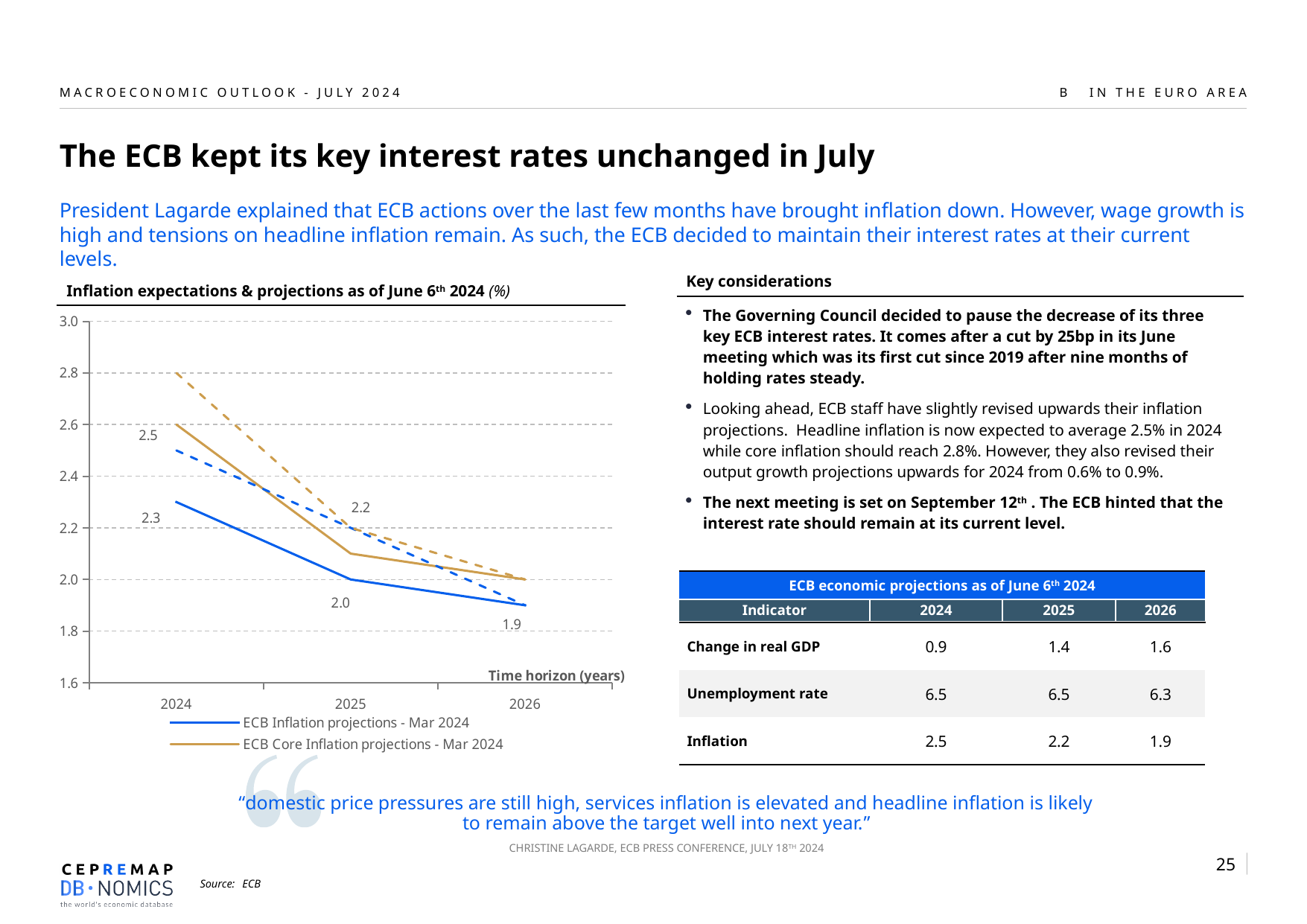
Is the value of ECB Core Inflation projections - Mar 2024 for 2025 greater or less than 2.0? greater What kind of chart is shown on the slide? line chart Do the values of ECB Inflation projections - Mar 2024 rise or fall from 2024 to 2026? fall What is the value of ECB Inflation projections - Mar 2024 for 2026? 1.9 For 2024, which is larger: ECB Core Inflation projections - Mar 2024 or ECB Inflation projections - Mar 2024? ECB Core Inflation projections - Mar 2024 In which year is ECB Inflation projections - Mar 2024 highest? 2024 What is the title of the x axis of the chart? Time horizon (years) Is the value of ECB Core Inflation projections - Mar 2024 for 2024 greater or less than 2.4? greater What is the value of ECB Inflation projections - Mar 2024 for 2025? 2.0 How many years are shown on the x axis of the chart? 3 How many series does the chart legend list? 2 What is the value of ECB Inflation projections - Mar 2024 for 2024? 2.3